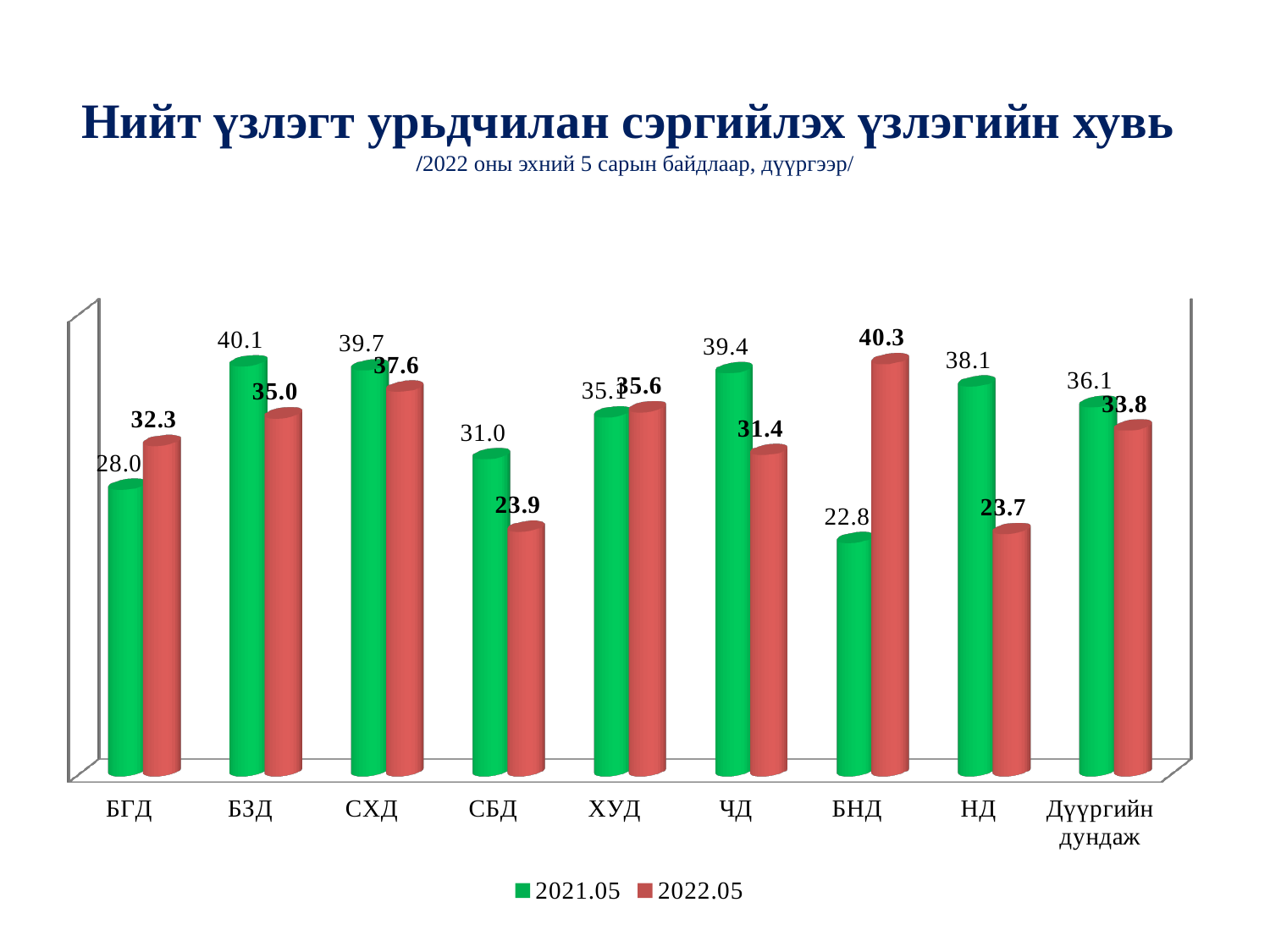
What is the difference between the 2021.05 and 2022.05 values for НД? 14.4 What is the 2021.05 value for БЗД? 40.1 What is the 2022.05 value for БНД? 40.3 Which category has the highest 2022.05 value? БНД What is the 2022.05 value for СБД? 23.9 What kind of chart is shown on the slide? Bar chart Which category has the lowest 2022.05 value? НД How many series does the legend list? 2 Which category has the lowest 2021.05 value? БНД For ЧД, which is larger: the 2021.05 value or the 2022.05 value? 2021.05 How many categories are shown on the x axis? 9 What is the 2021.05 value for Дүүргийн дундаж? 36.1